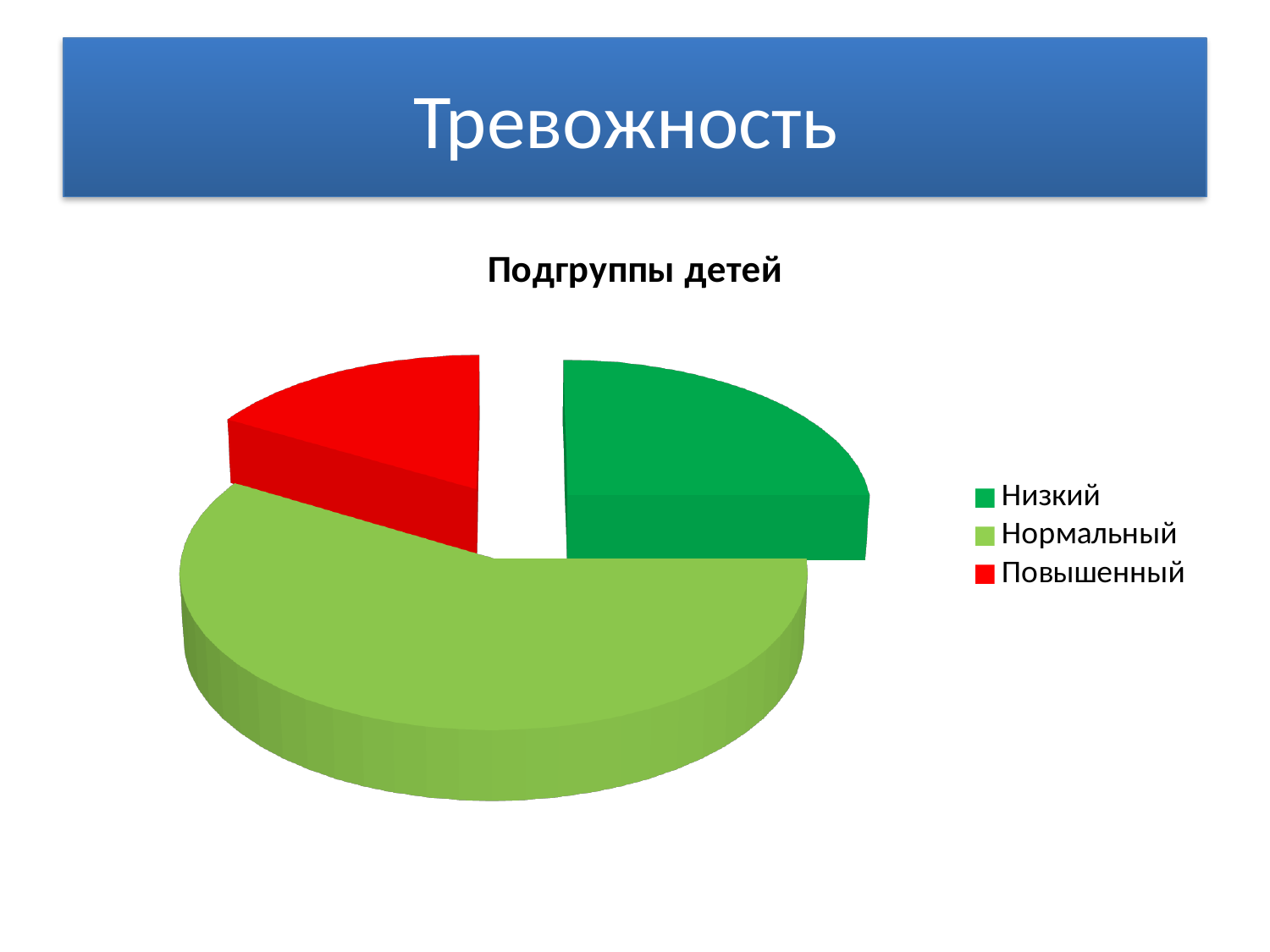
What kind of chart is shown on the slide? pie chart What is the title of the chart? Подгруппы детей Which category has the largest slice of the pie? Нормальный Which is larger, the slice for Нормальный or the slice for Низкий? Нормальный How many entries does the legend list? 3 What colour is the slice for Повышенный? red Does the Нормальный slice take up more or less than half of the pie? more Which is larger, the slice for Нормальный or the slice for Повышенный? Нормальный How many slices does the pie chart have? 3